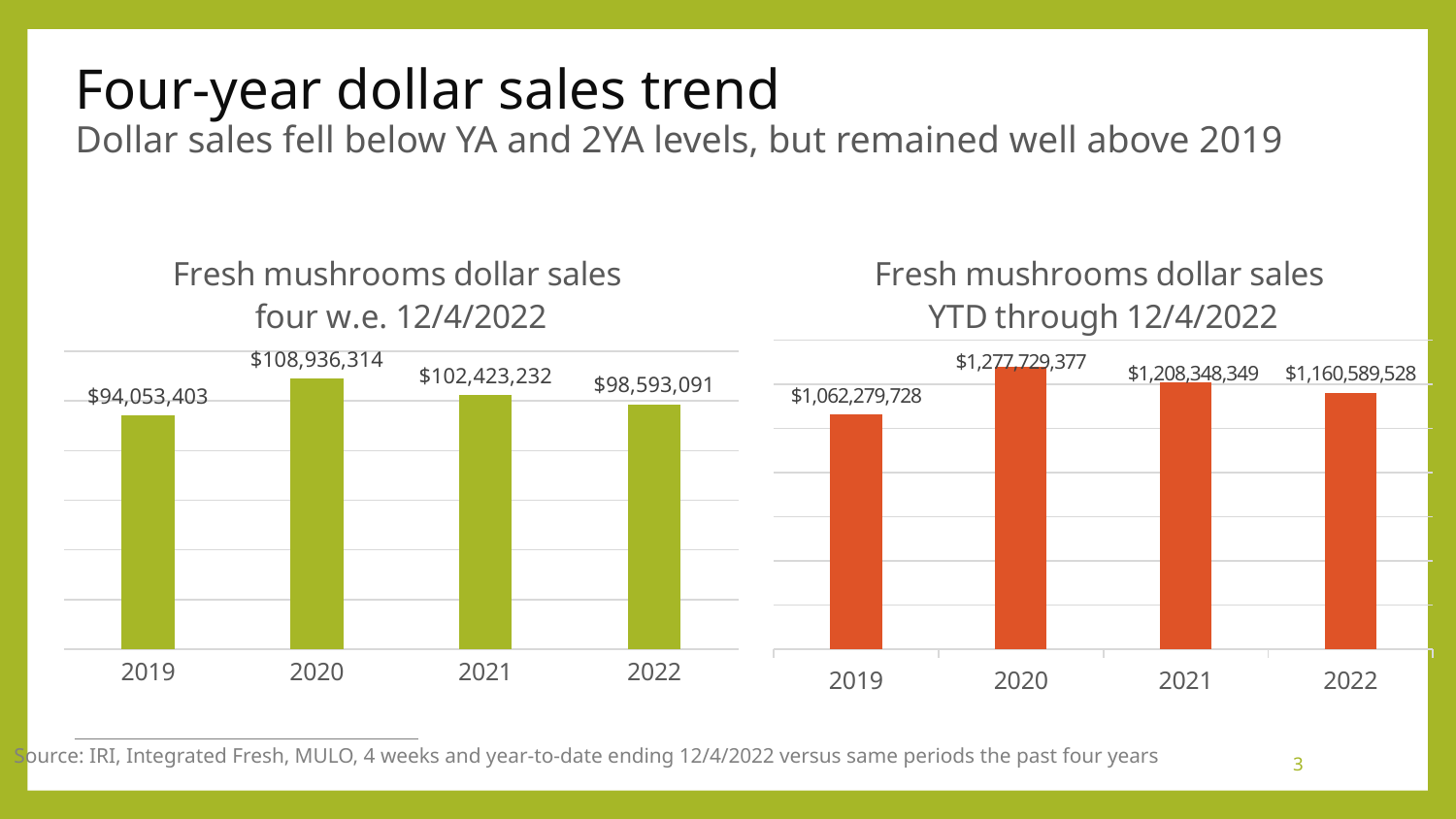
In the 'Fresh mushrooms dollar sales four w.e. 12/4/2022' chart, which year has the highest value? 2020 In the 'Fresh mushrooms dollar sales YTD through 12/4/2022' chart, which year has the lowest value? 2019 What kind of chart is the 'Fresh mushrooms dollar sales four w.e. 12/4/2022' chart? Bar chart In the 'Fresh mushrooms dollar sales YTD through 12/4/2022' chart, what is the difference between the 2020 and 2022 values? $117,139,849 In the 'Fresh mushrooms dollar sales four w.e. 12/4/2022' chart, what is the value for 2022? $98,593,091 In the 'Fresh mushrooms dollar sales four w.e. 12/4/2022' chart, what is the value for 2019? $94,053,403 In the 'Fresh mushrooms dollar sales YTD through 12/4/2022' chart, what is the value for 2021? $1,208,348,349 In the 'Fresh mushrooms dollar sales four w.e. 12/4/2022' chart, which is larger, the value for 2021 or the value for 2022? 2021 How many years are shown in the 'Fresh mushrooms dollar sales YTD through 12/4/2022' chart? 4 In the 'Fresh mushrooms dollar sales YTD through 12/4/2022' chart, what is the value for 2019? $1,062,279,728 In the 'Fresh mushrooms dollar sales four w.e. 12/4/2022' chart, what is the difference between the 2020 and 2019 values? $14,882,911 In the 'Fresh mushrooms dollar sales YTD through 12/4/2022' chart, do the values rise or fall from 2020 to 2022? Fall